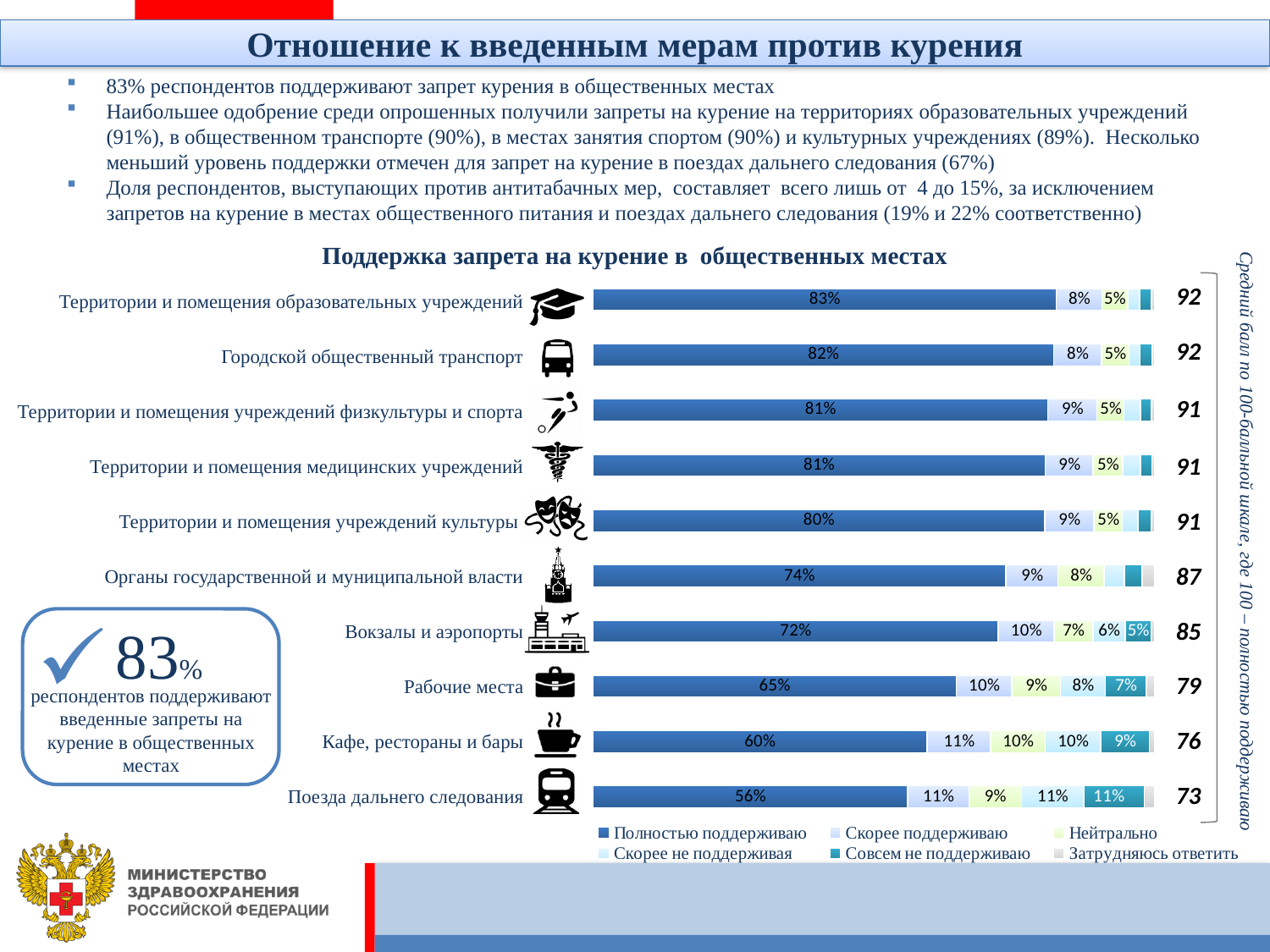
How many series does the chart legend list? 6 What is the difference between the "Полностью поддерживаю" values for "Рабочие места" and "Поезда дальнего следования"? 9% Which has a larger "Полностью поддерживаю" value: "Вокзалы и аэропорты" or "Рабочие места"? Вокзалы и аэропорты Which category has the lowest "Полностью поддерживаю" value? Поезда дальнего следования What kind of chart is shown under the title "Поддержка запрета на курение в общественных местах"? Stacked bar chart What is the "Полностью поддерживаю" value for "Территории и помещения образовательных учреждений"? 83% What is the "Совсем не поддерживаю" value for "Поезда дальнего следования"? 11% What is the "Полностью поддерживаю" value for "Кафе, рестораны и бары"? 60% What is the "Полностью поддерживаю" value for "Поезда дальнего следования"? 56% How many categories (public places) are plotted in the chart? 10 What is the average score (средний балл) shown to the right of the bar for "Органы государственной и муниципальной власти"? 87 Which category has the highest "Полностью поддерживаю" value? Территории и помещения образовательных учреждений